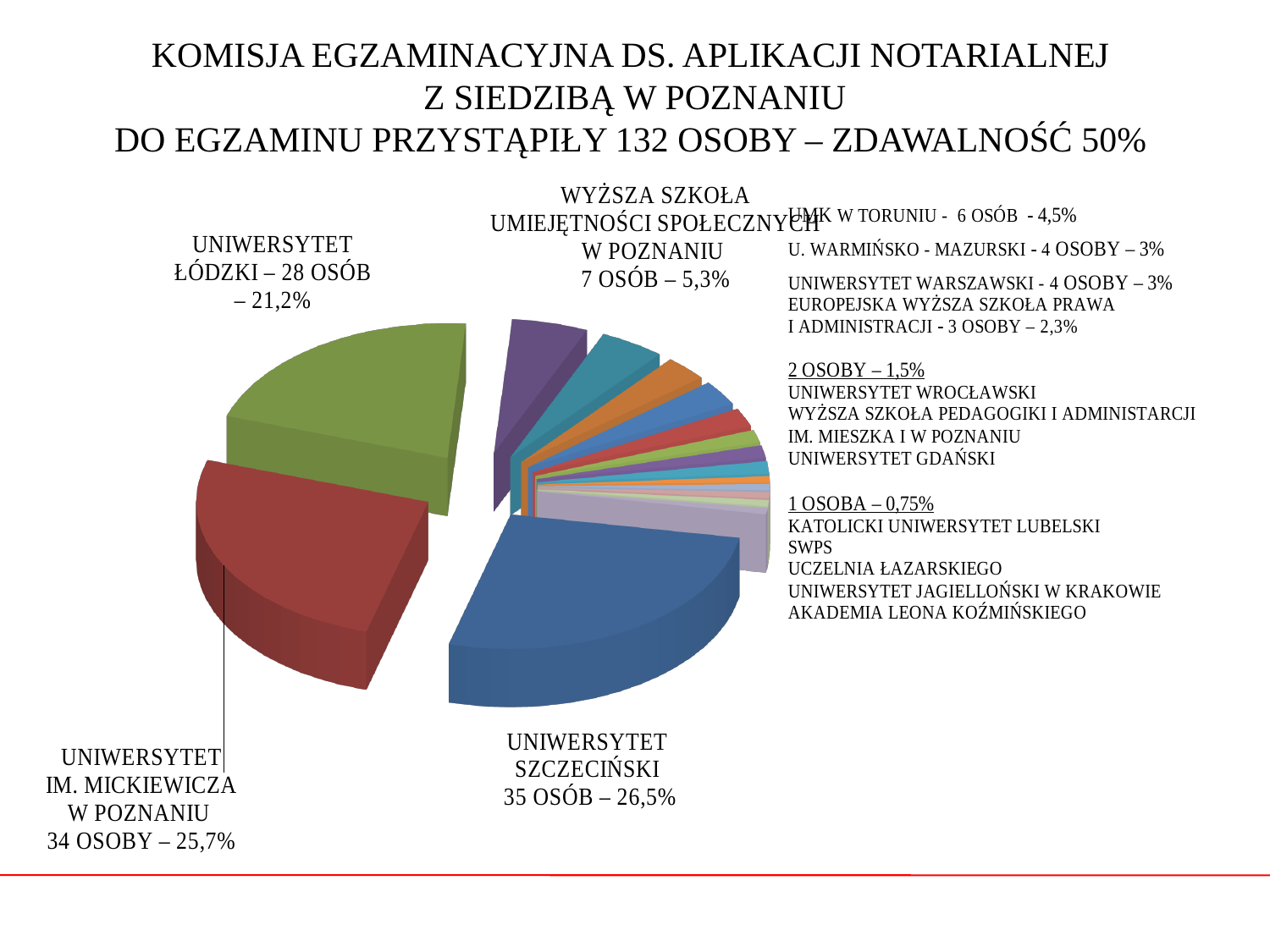
What share of the pie does Uniwersytet im. Mickiewicza w Poznaniu represent? 25,7% Which university has the largest slice of the pie? Uniwersytet Szczeciński What pass rate (zdawalność) is given in the slide title? 50% How many people from Uniwersytet Szczeciński took the exam? 35 How many people from Uniwersytet Łódzki took the exam? 28 What kind of chart is shown on the slide? pie chart What percentage corresponds to 1 osoba (one person) on the slide? 0,75% What percentage is shown for Wyższa Szkoła Umiejętności Społecznych w Poznaniu? 5,3% Which has more people: Uniwersytet Łódzki or UMK w Toruniu? Uniwersytet Łódzki What is the difference in number of people between Uniwersytet Szczeciński and Uniwersytet Łódzki? 7 How many people from UMK w Toruniu took the exam? 6 How many people in total took the exam according to the slide title? 132